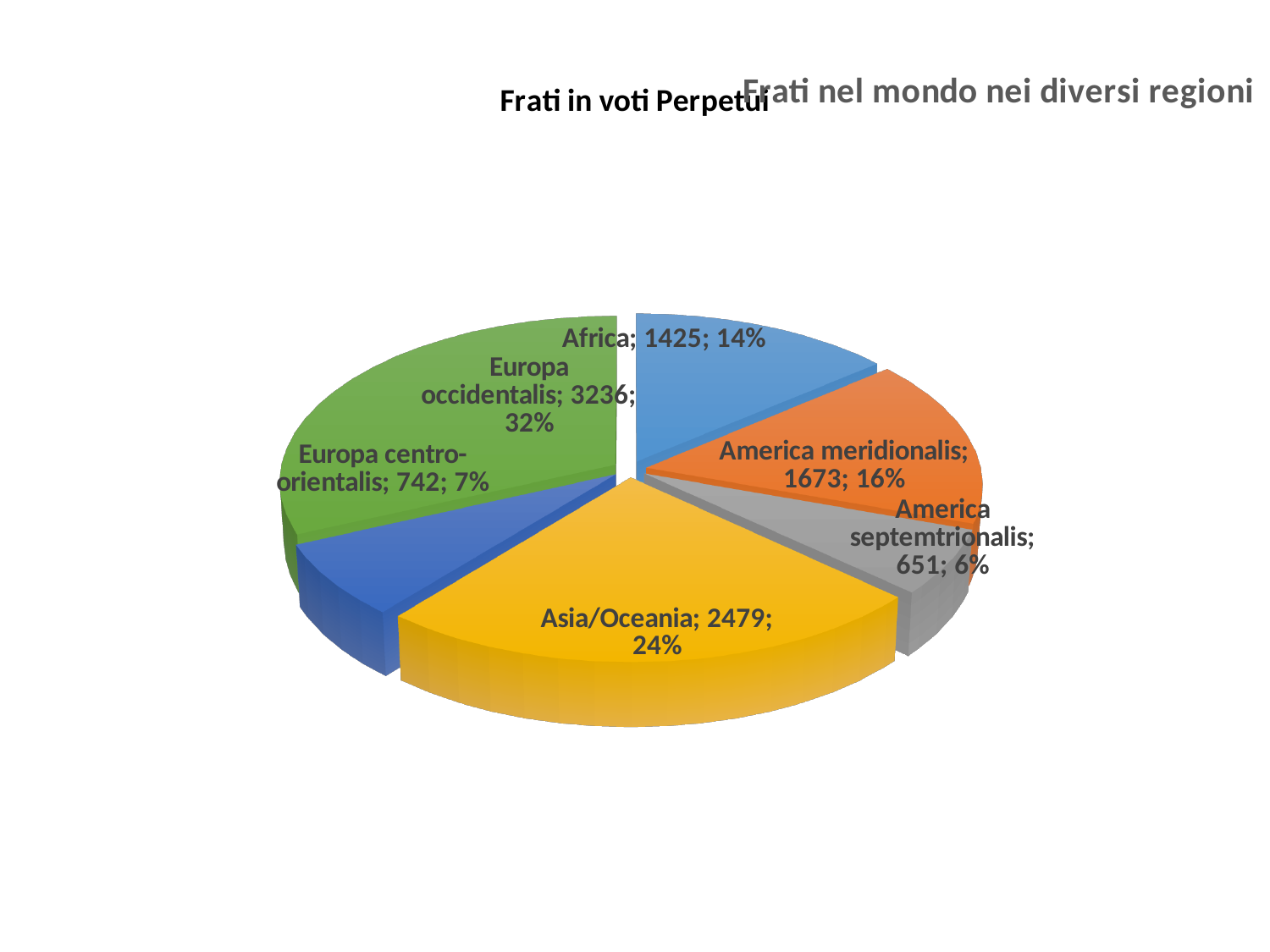
What is the value for Africa? 1425 What is the value for Asia/Oceania? 2479 Which is larger, the value for Africa or the value for America meridionalis? America meridionalis Which region has the largest slice? Europa occidentalis Which region has the smallest slice? America septemtrionalis What is the value for America septemtrionalis? 651 What percentage share does Europa occidentalis have? 32% What kind of chart is shown on the slide? Pie chart What is the difference between the values for Europa occidentalis and Asia/Oceania? 757 What is the title of the chart? Frati nel mondo nei diversi regioni How many regions are shown in the pie chart? 6 What percentage share does America meridionalis have? 16%